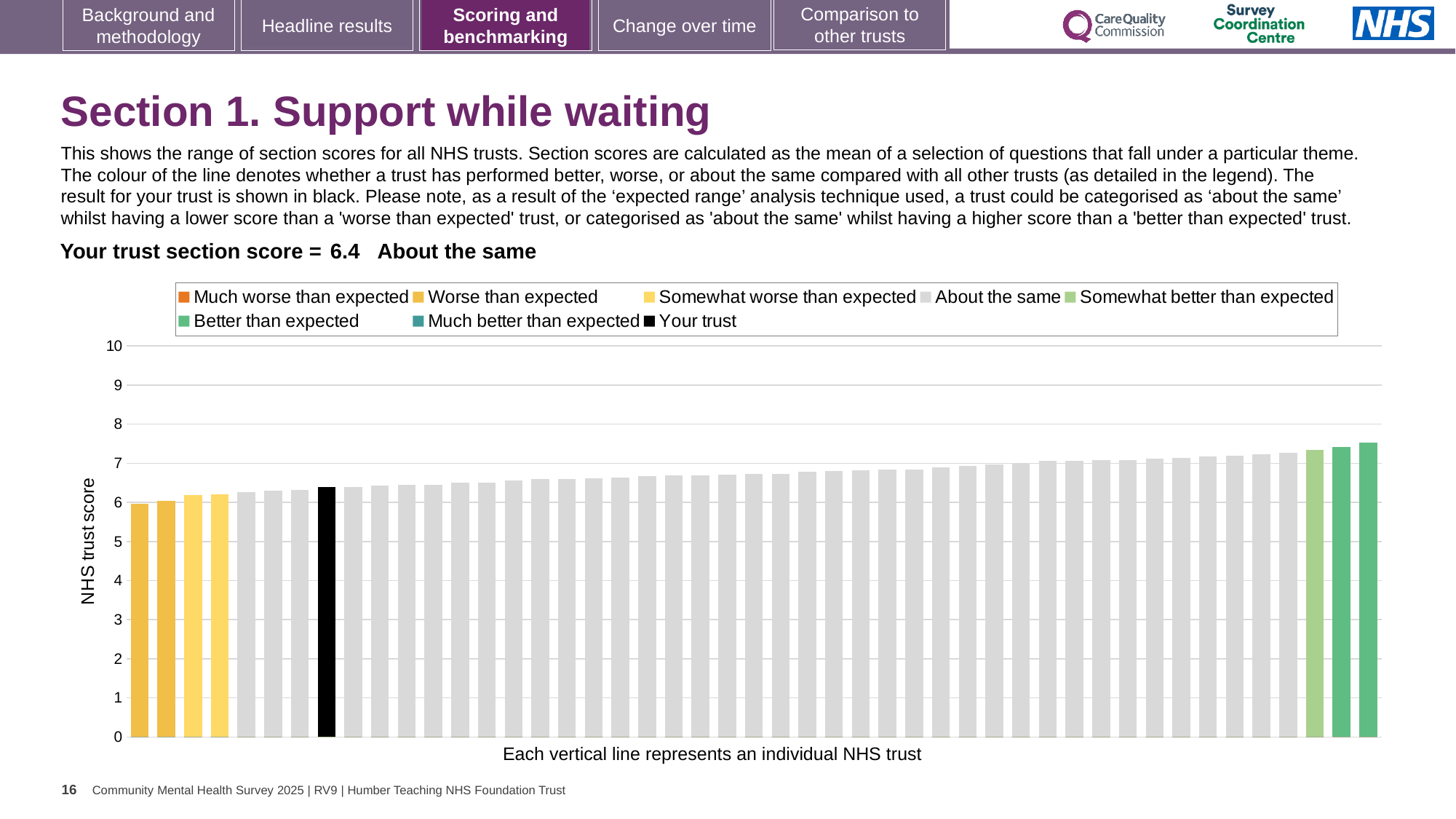
How many bars are coloured as 'Better than expected'? 2 Do the bar values rise or fall from left to right along the x axis? rise Is the value of the tallest bar greater or less than 7? greater Which legend category do the tallest bars on the chart belong to? Better than expected What is the section score for your trust shown on the slide? 6.4 Is the value for your trust (the black bar) greater or less than 6? greater How many entries does the chart legend list? 8 Is the value of the shortest bar greater or less than 7? less What kind of chart is shown on the slide? bar chart How many bars are coloured as 'Somewhat better than expected'? 1 What is the label on the vertical axis of the chart? NHS trust score